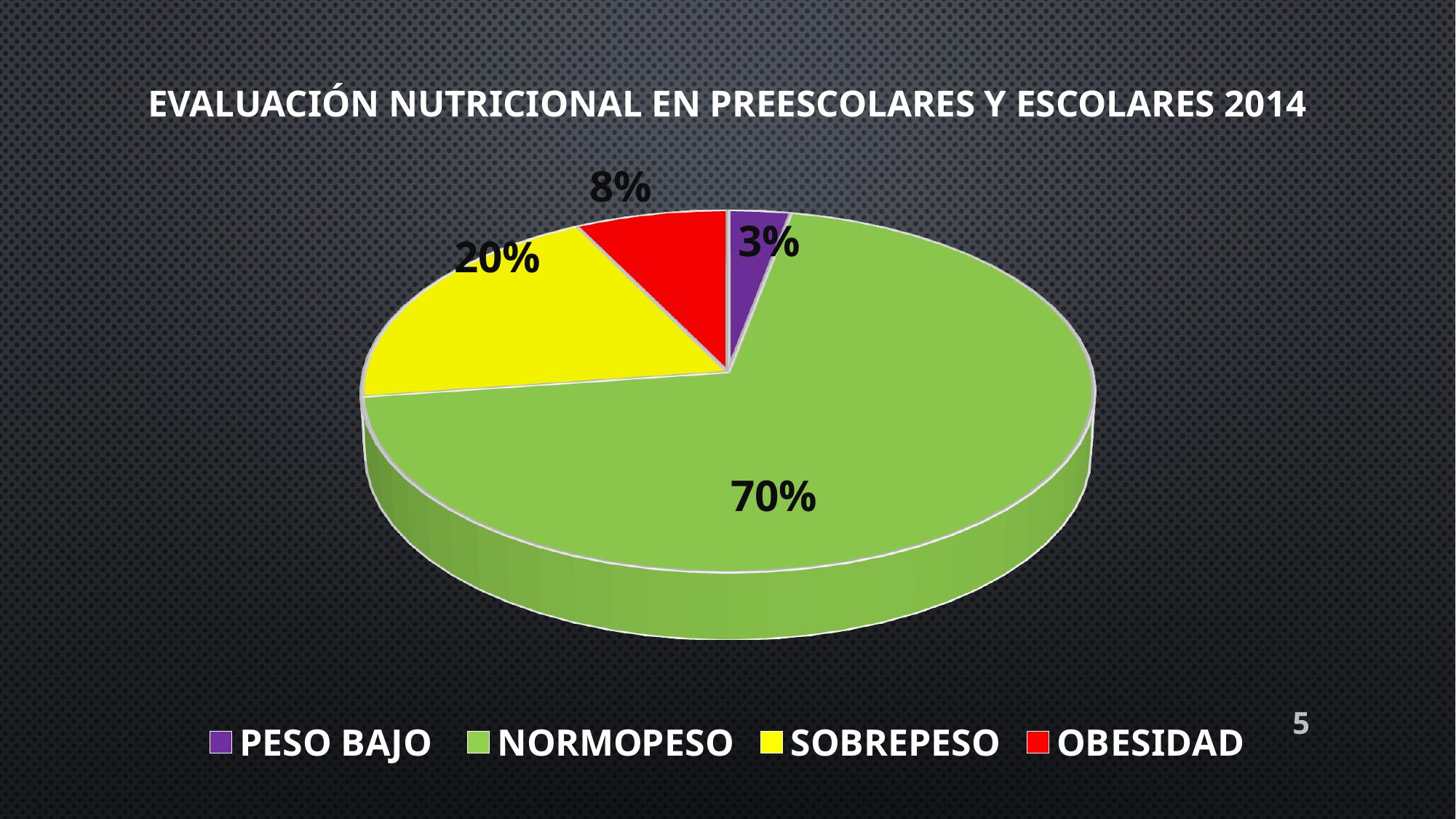
How many categories does the pie chart show? 4 What is the difference in percentage points between OBESIDAD and PESO BAJO? 5 Which category has the smallest share of the pie? PESO BAJO What is the title of the chart? EVALUACIÓN NUTRICIONAL EN PREESCOLARES Y ESCOLARES 2014 Which category has the largest share of the pie? NORMOPESO What kind of chart is shown on the slide? Pie chart What percentage of the pie is SOBREPESO? 20% What percentage of the pie is OBESIDAD? 8% What percentage of the pie is NORMOPESO? 70% Which is larger, the share for SOBREPESO or the share for OBESIDAD? SOBREPESO What is the difference in percentage points between NORMOPESO and SOBREPESO? 50 What percentage of the pie is PESO BAJO? 3%